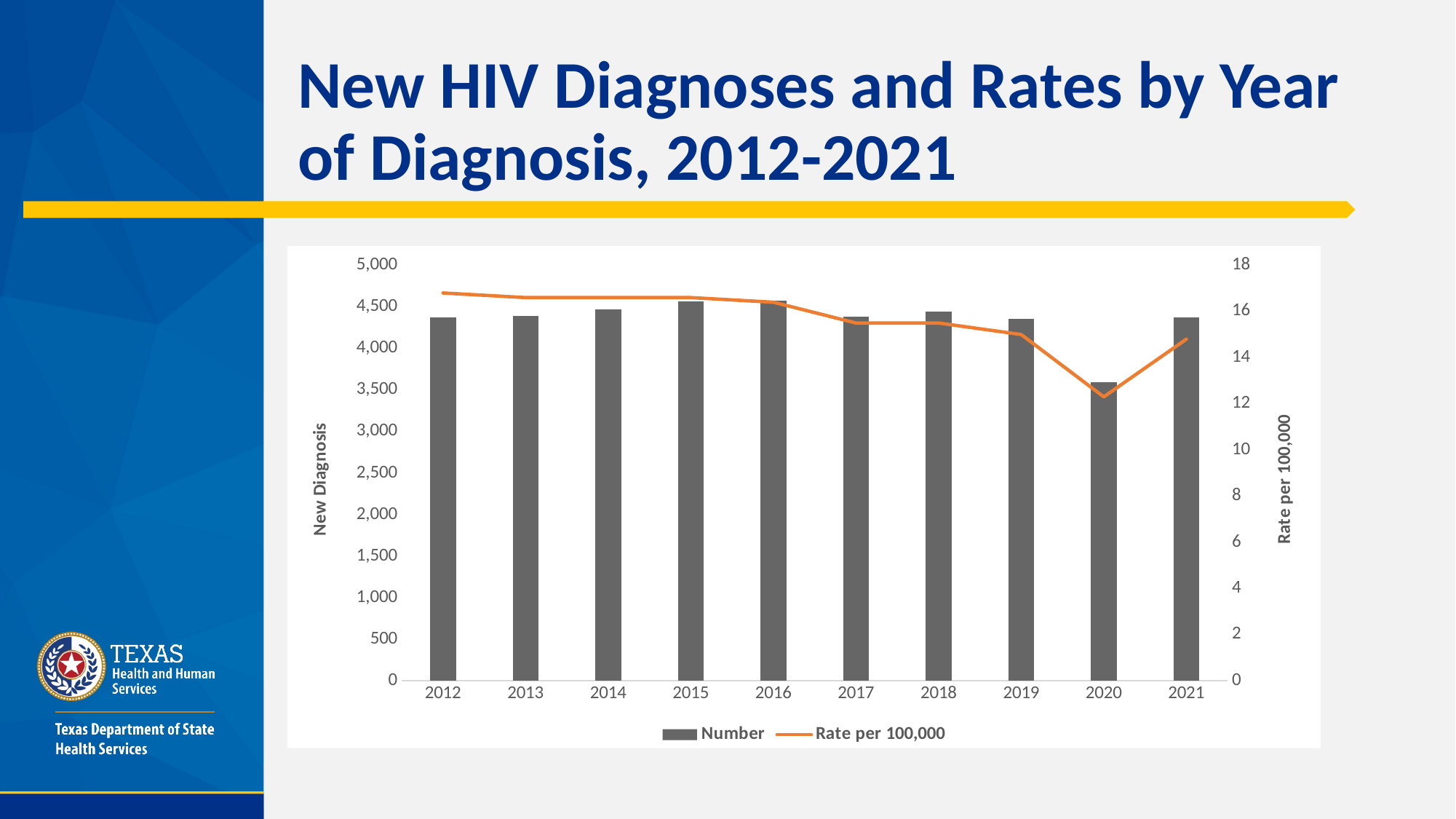
Is the rate per 100,000 in 2020 greater or less than 14? less Is the number of new diagnoses in 2020 greater or less than 4,000? less Is the number of new diagnoses in 2016 greater or less than 4,000? greater Which year has the larger number of new diagnoses, 2020 or 2021? 2021 How many years are shown on the x axis of the chart? 10 Which year has the lowest number of new HIV diagnoses? 2020 What is the label of the right-hand vertical axis? Rate per 100,000 How many series does the chart's legend list? 2 In which year is the rate per 100,000 lowest? 2020 What kind of chart is shown on the slide? A combination bar and line chart Does the rate per 100,000 rise or fall from 2016 to 2020? fall